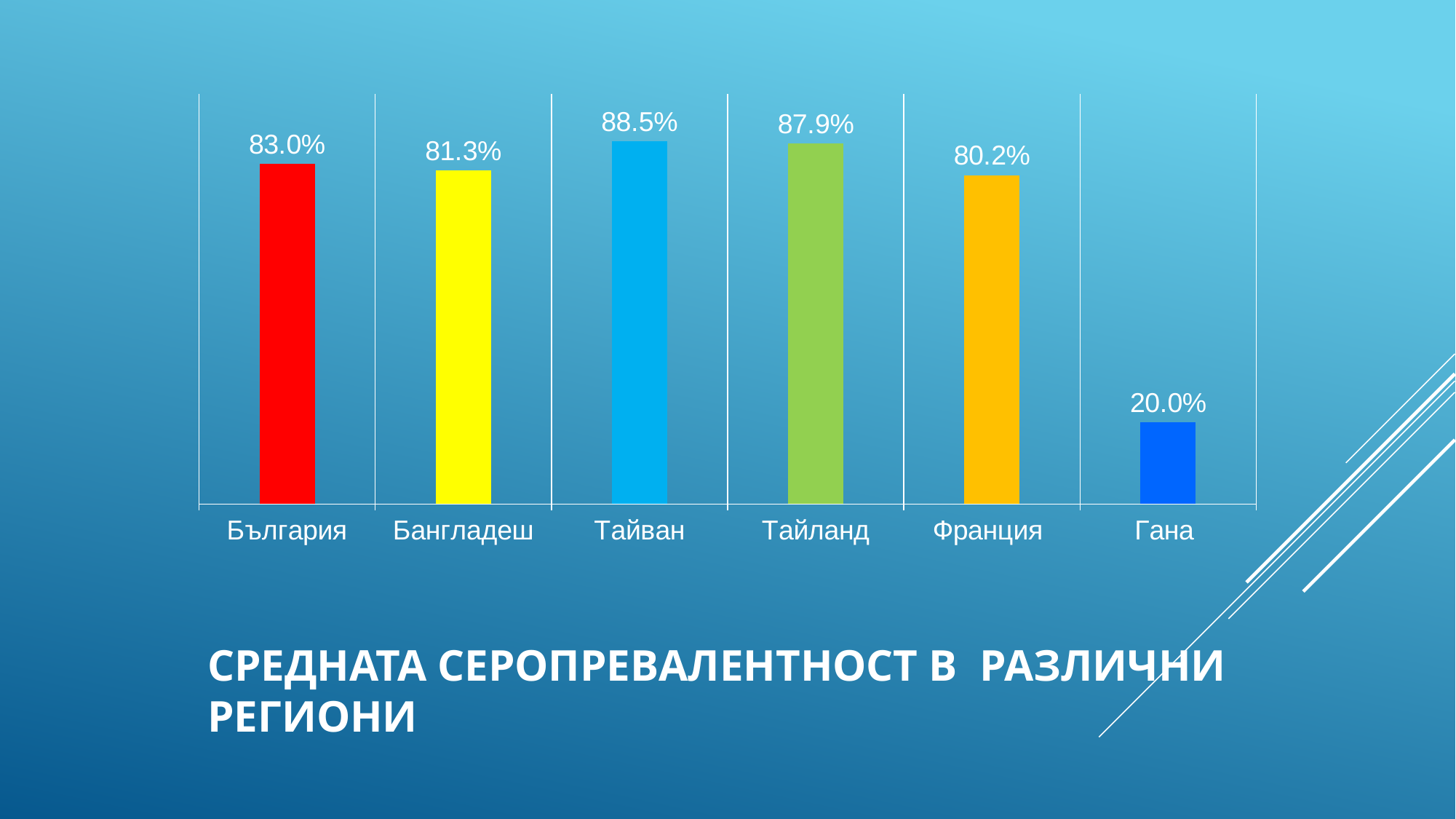
Which category has the lowest value? Гана What is the value for Тайван? 88.5% What is the value for Франция? 80.2% What is the difference between the values for Тайван and Гана? 68.5% What is the value for Гана? 20.0% What colour is the bar for Бангладеш? Yellow What is the value for България? 83.0% What kind of chart is shown on the slide? Bar chart How many categories are shown in the chart? 6 What is the difference between the values for България and Бангладеш? 1.7% Which category has the highest value? Тайван Which is larger, the value for Тайланд or the value for Франция? Тайланд